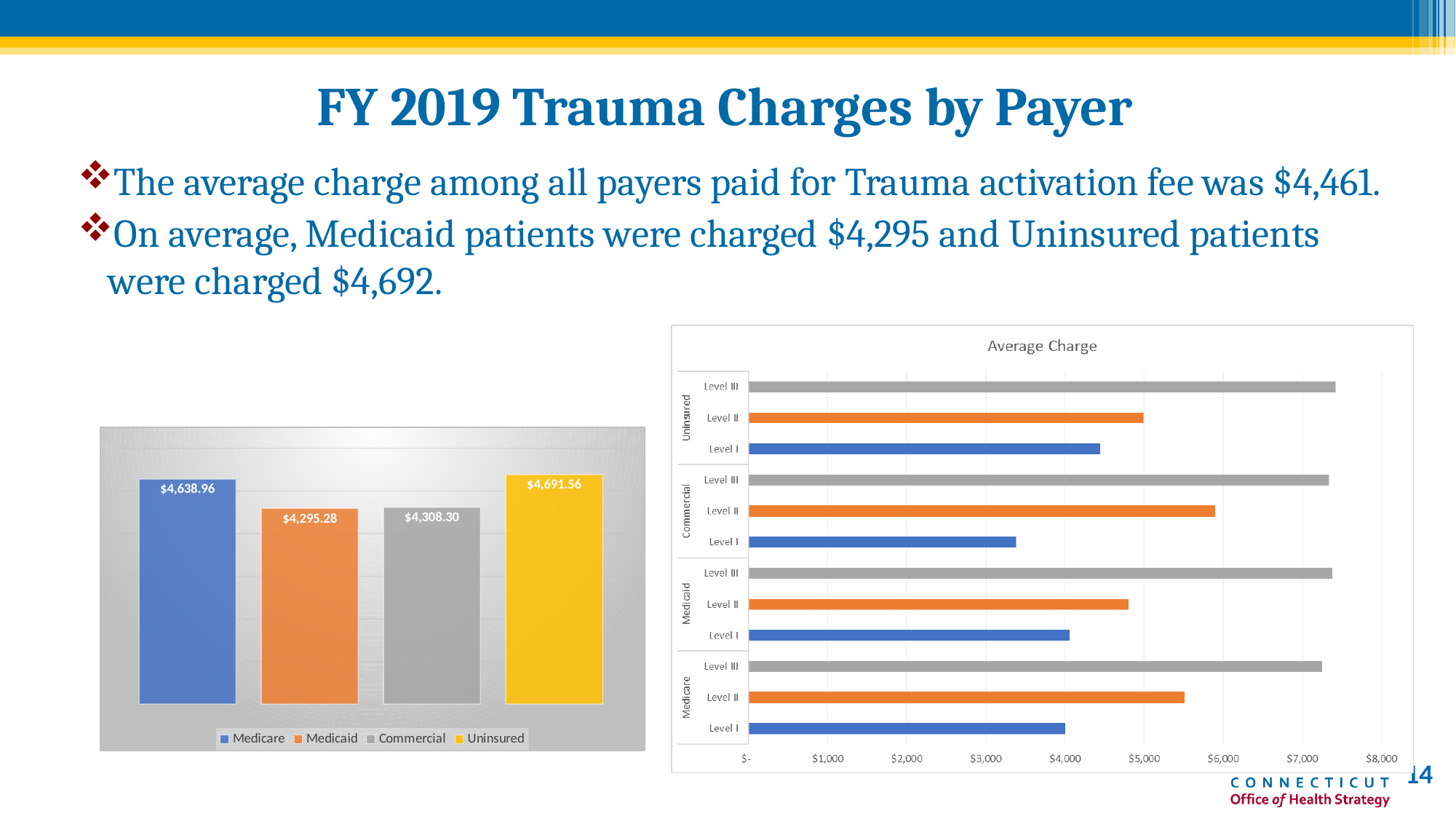
How many series does the legend of the left chart list? 4 In the 'Average Charge' chart on the right, is the value for Medicare Level II greater or less than $5,000? greater In the left bar chart, which payer has the lowest average charge? Medicaid In the 'Average Charge' chart on the right, is the value for Commercial Level I greater or less than $4,000? less What kind of chart is the chart titled 'Average Charge' on the right? Bar chart In the 'Average Charge' chart on the right, is the value for Uninsured Level III greater or less than $7,000? greater In the left bar chart, what is the difference between the Uninsured and Medicare values? $52.60 How many bars are plotted in the 'Average Charge' chart on the right? 12 In the left bar chart, what is the value for Commercial? $4,308.30 In the left bar chart, what is the value for Medicare? $4,638.96 In the left bar chart, which payer has the highest average charge? Uninsured In the left bar chart, which is larger, the Commercial value or the Medicaid value? Commercial